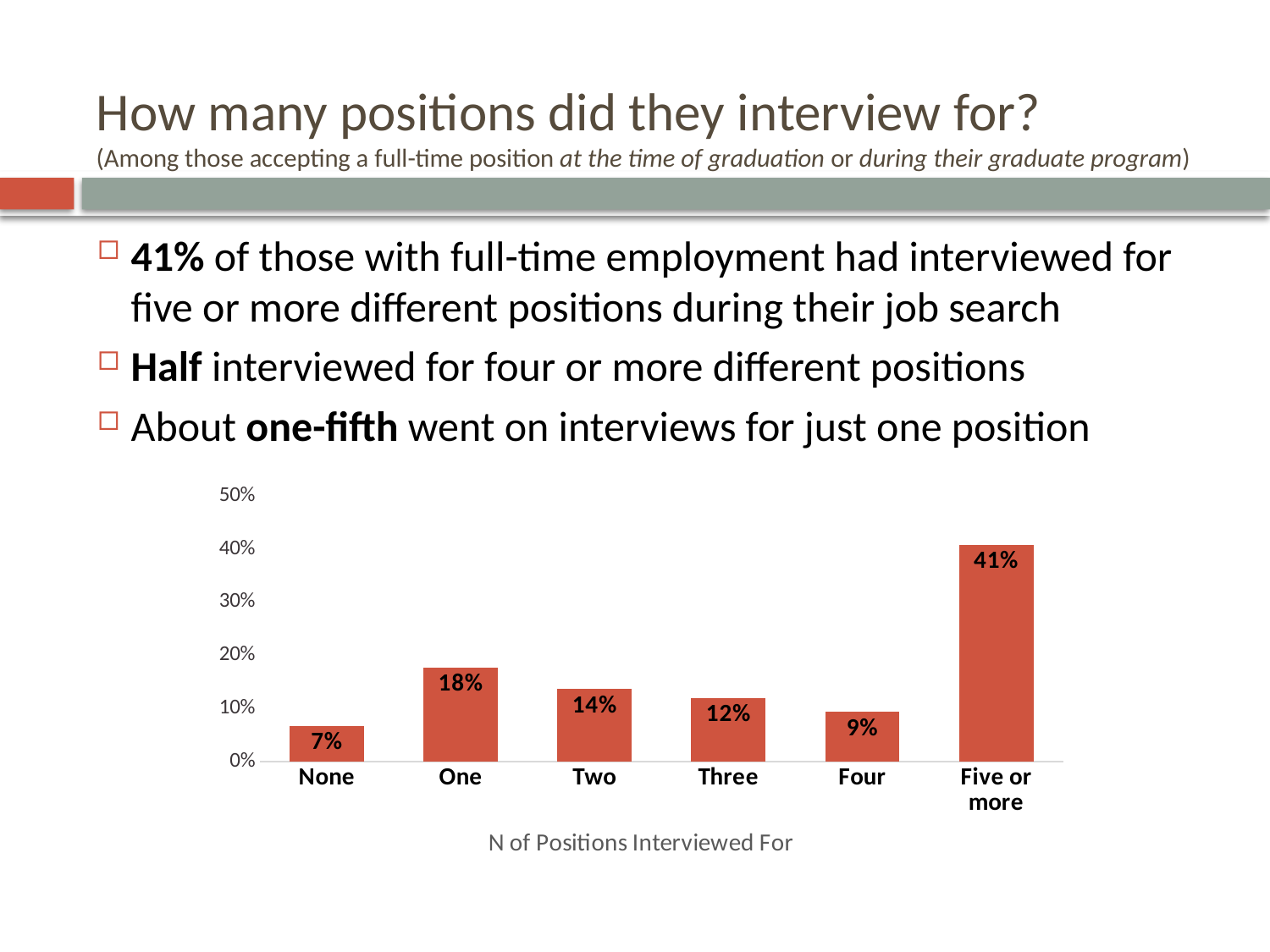
Do the values fall or rise from 'One' to 'Four' along the x axis? fall Which category has the highest value in the chart? Five or more Is the value for 'Five or more' greater or less than 30%? greater How many categories are shown on the x axis of the chart? 6 What is the value shown for the 'None' category? 7% What kind of chart is shown on the slide? bar chart What percentage interviewed for exactly two positions? 14% What is the difference between the values for 'One' and 'Three'? 6% Which category has the lowest value in the chart? None Which is larger, the value for 'Two' or the value for 'Four'? Two What percentage of respondents interviewed for five or more positions? 41% What is the x-axis title of the chart? N of Positions Interviewed For